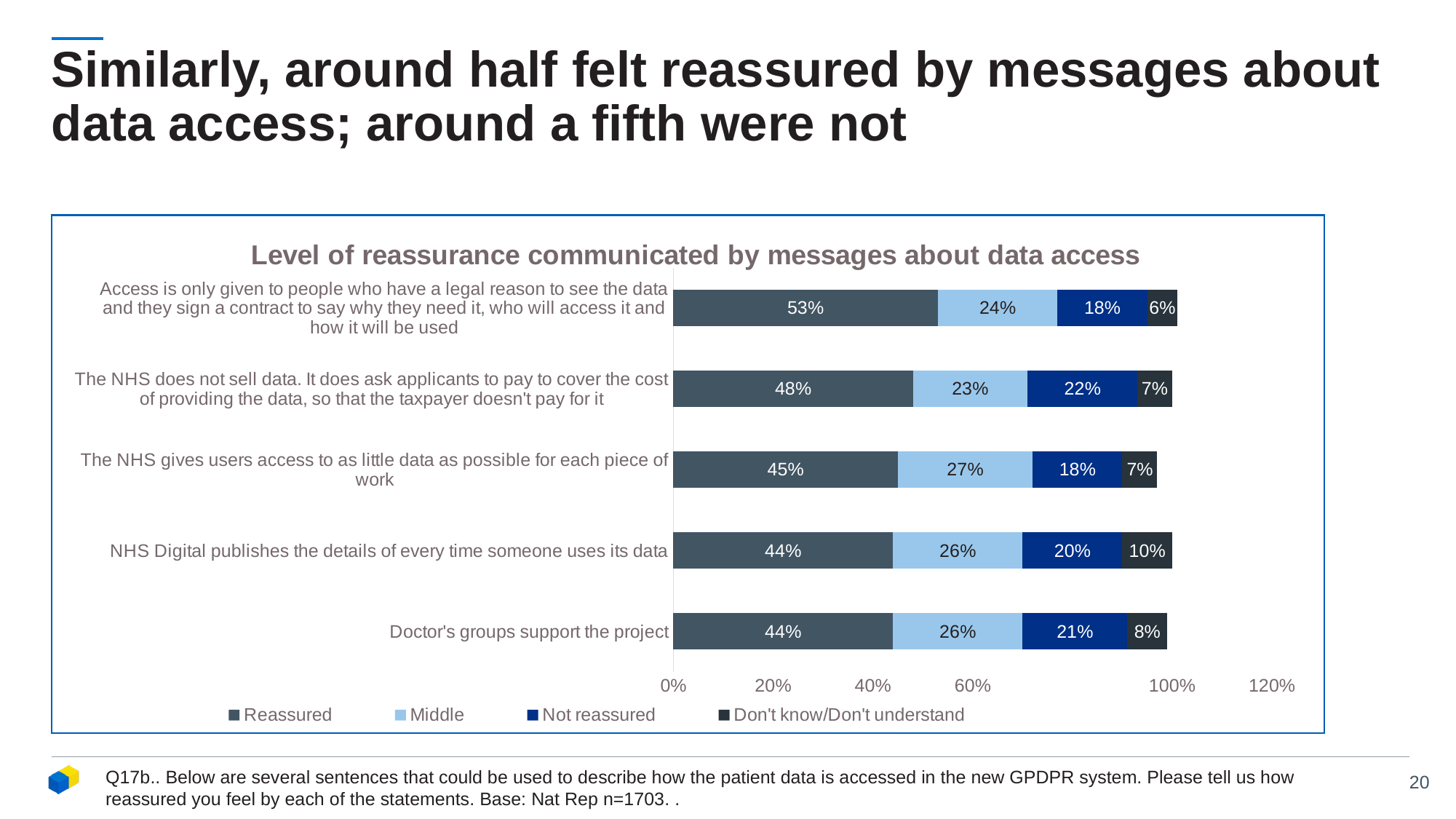
For "Doctor's groups support the project", how many percentage points higher is Reassured than Not reassured? 23 percentage points What type of chart is shown on the slide? Stacked bar chart What is the total of the labelled segments for "Doctor's groups support the project"? 99% How many statements are shown in the chart? 5 Which statement has the highest Reassured percentage? Access is only given to people who have a legal reason to see the data and they sign a contract to say why they need it, who will access it and how it will be used What is the Middle percentage for the statement "Doctor's groups support the project"? 26% Which statement has the lowest Don't know/Don't understand percentage? Access is only given to people who have a legal reason to see the data and they sign a contract to say why they need it, who will access it and how it will be used Which statement has a higher Middle percentage: "The NHS gives users access to as little data as possible for each piece of work" or "The NHS does not sell data..."? The NHS gives users access to as little data as possible for each piece of work How many series does the legend list? 4 Which statement has the highest Not reassured percentage? The NHS does not sell data. It does ask applicants to pay to cover the cost of providing the data, so that the taxpayer doesn't pay for it What percentage were reassured by the statement "NHS Digital publishes the details of every time someone uses its data"? 44% What percentage were not reassured by the statement "The NHS does not sell data. It does ask applicants to pay to cover the cost of providing the data, so that the taxpayer doesn't pay for it"? 22%